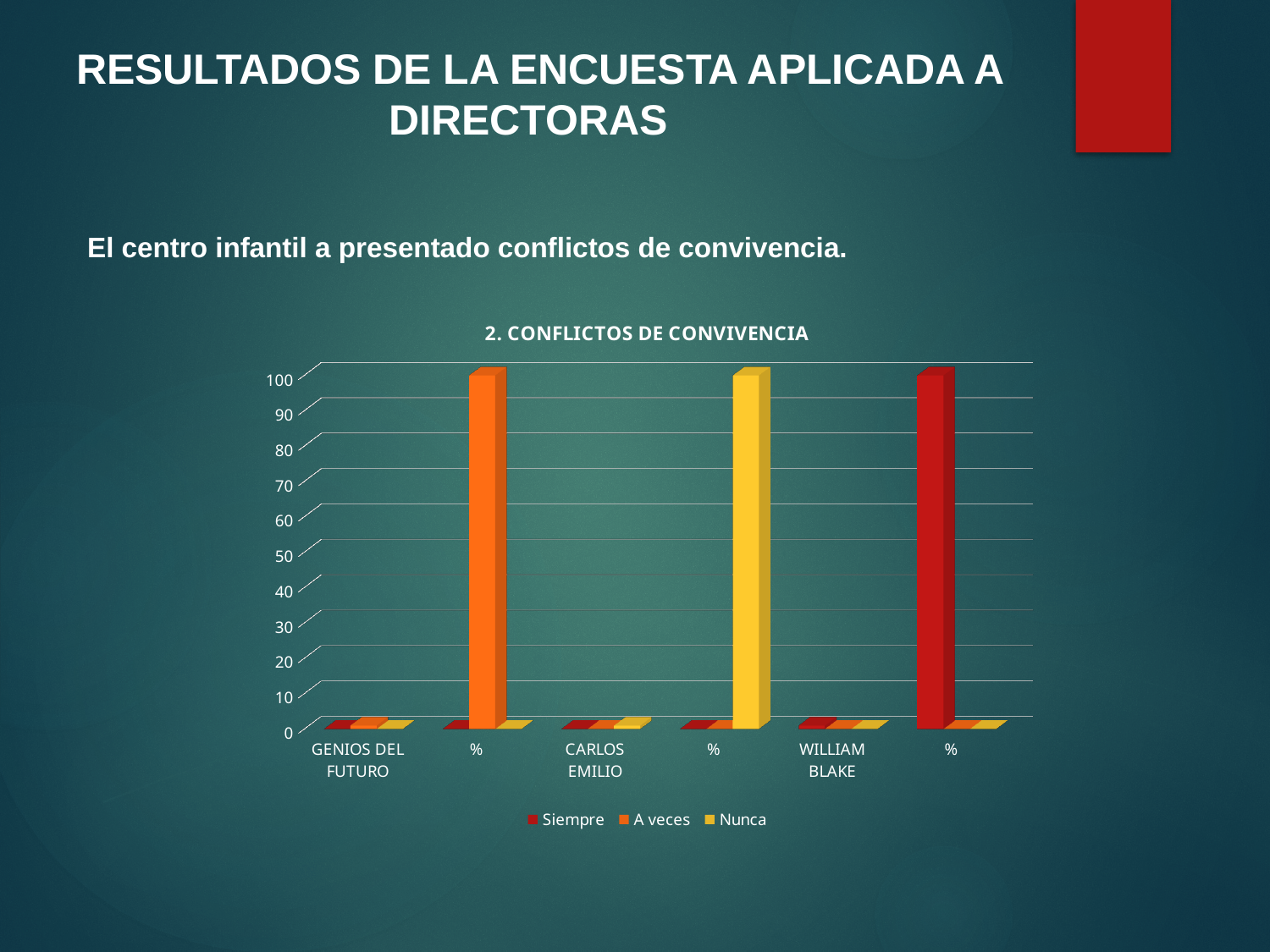
Which series has the tallest bar in the '%' category next to CARLOS EMILIO? Nunca Which is larger in the '%' category next to WILLIAM BLAKE: the 'Siempre' bar or the 'Nunca' bar? Siempre What is the highest value shown on the vertical axis of the chart? 100 Which series are listed in the chart legend? Siempre, A veces, Nunca Which series has the tallest bar in the '%' category next to GENIOS DEL FUTURO? A veces What type of chart is shown on the slide? bar chart Is the 'A veces' value in the '%' category next to GENIOS DEL FUTURO greater or less than 50? greater How many categories are shown along the x axis of the chart? 6 Which series has the tallest bar in the '%' category next to WILLIAM BLAKE? Siempre Is the 'Siempre' value in the '%' category next to CARLOS EMILIO greater or less than 10? less What is the title of the chart? 2. CONFLICTOS DE CONVIVENCIA How many series does the chart legend list? 3